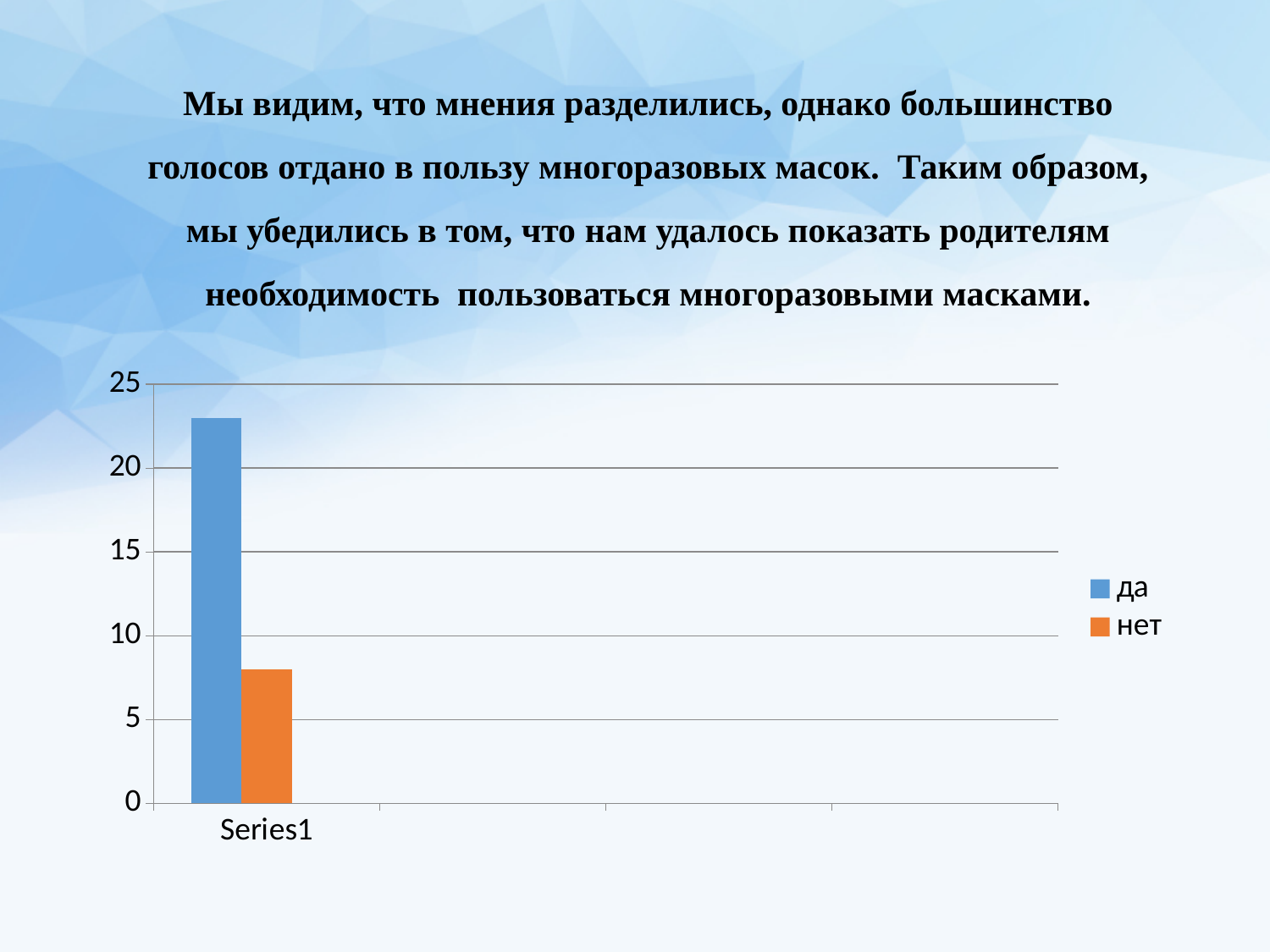
Is the value for да greater or less than 25? less Which series has the taller bar, да or нет? да Which series has the lowest value? нет What is the label of the category on the x axis? Series1 Is the value for да greater or less than 20? greater Is the value for нет greater or less than 5? greater Which series has the highest value? да What colour is the bar for нет? orange How many series does the legend list? 2 What kind of chart is shown on the slide? bar chart How many categories are shown on the x axis? 1